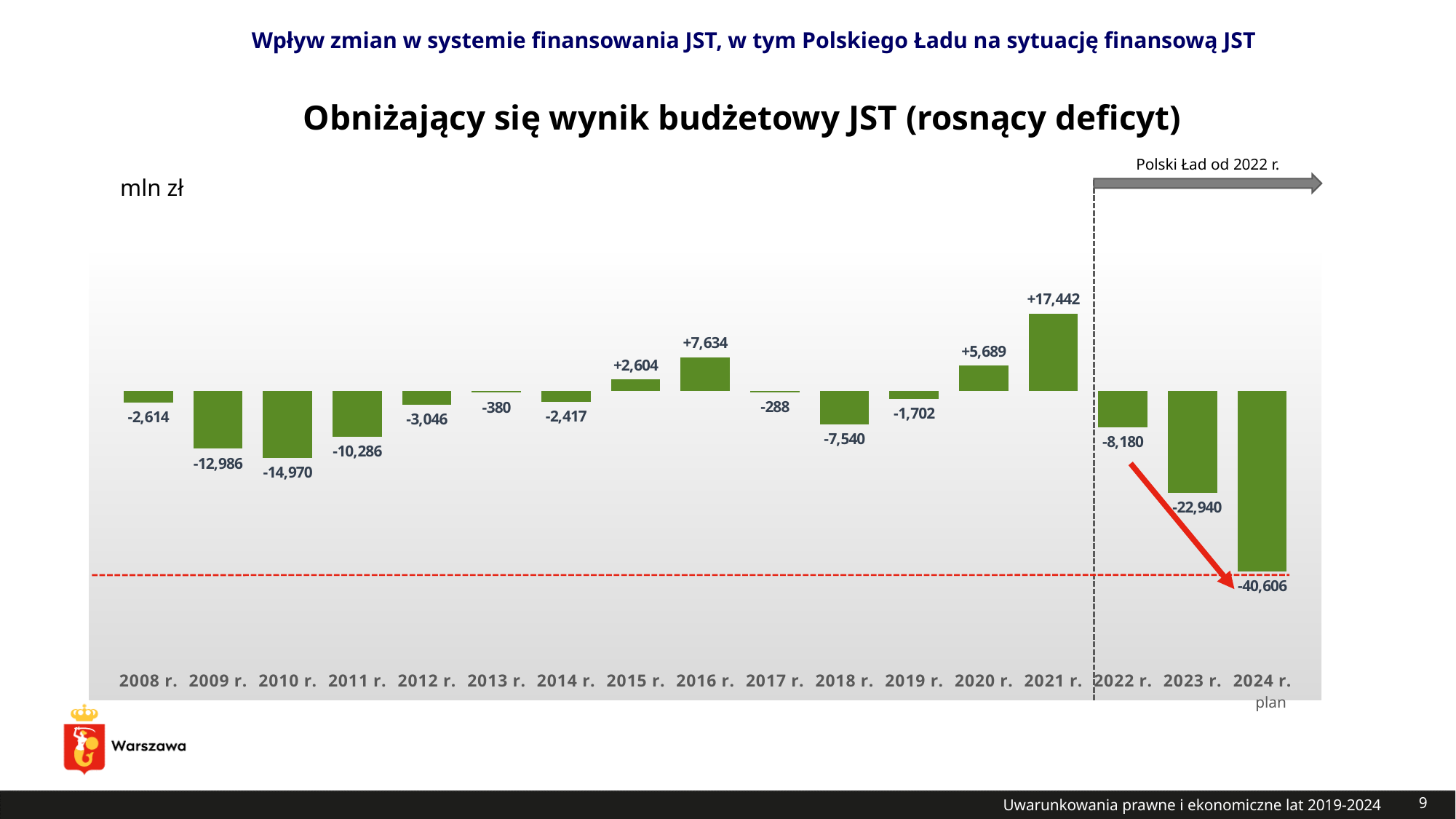
What is the value for 2024 r. (plan)? -40,606 Which year has the lowest value? 2024 r. What is the value for 2010 r.? -14,970 What is the value for 2017 r.? -288 How many years are shown on the x axis? 17 What is the value for 2021 r.? +17,442 What is the difference between the values for 2023 r. and 2024 r.? 17,666 What is the difference between the values for 2021 r. and 2022 r.? 25,622 Which year has the highest value? 2021 r. What unit is indicated for the values in the chart? mln zł What kind of chart is shown? Bar chart Which is larger, the value for 2015 r. or the value for 2016 r.? 2016 r.